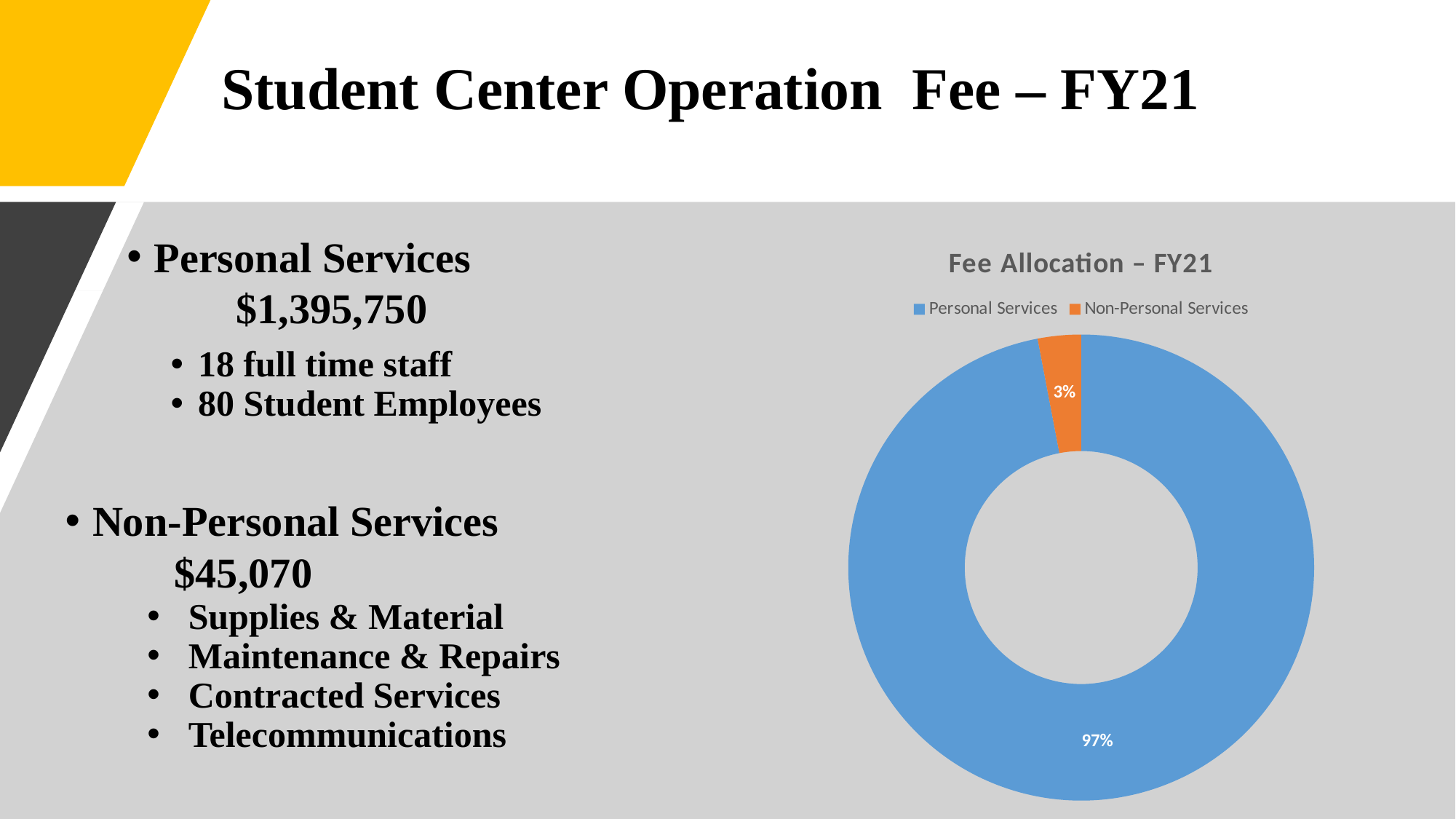
What is the title of the chart? Fee Allocation – FY21 Which is larger, the share for Personal Services or the share for Non-Personal Services? Personal Services How many entries does the chart legend list? 2 How many categories does the chart show? 2 What is the difference in percentage points between the Personal Services share and the Non-Personal Services share? 94 percentage points What kind of chart is shown on the slide? doughnut chart What colour represents Non-Personal Services in the chart? orange What share of the fee allocation goes to Personal Services? 97% Which category has the largest share of the fee allocation? Personal Services Which category has the smallest share of the fee allocation? Non-Personal Services What share of the fee allocation goes to Non-Personal Services? 3%